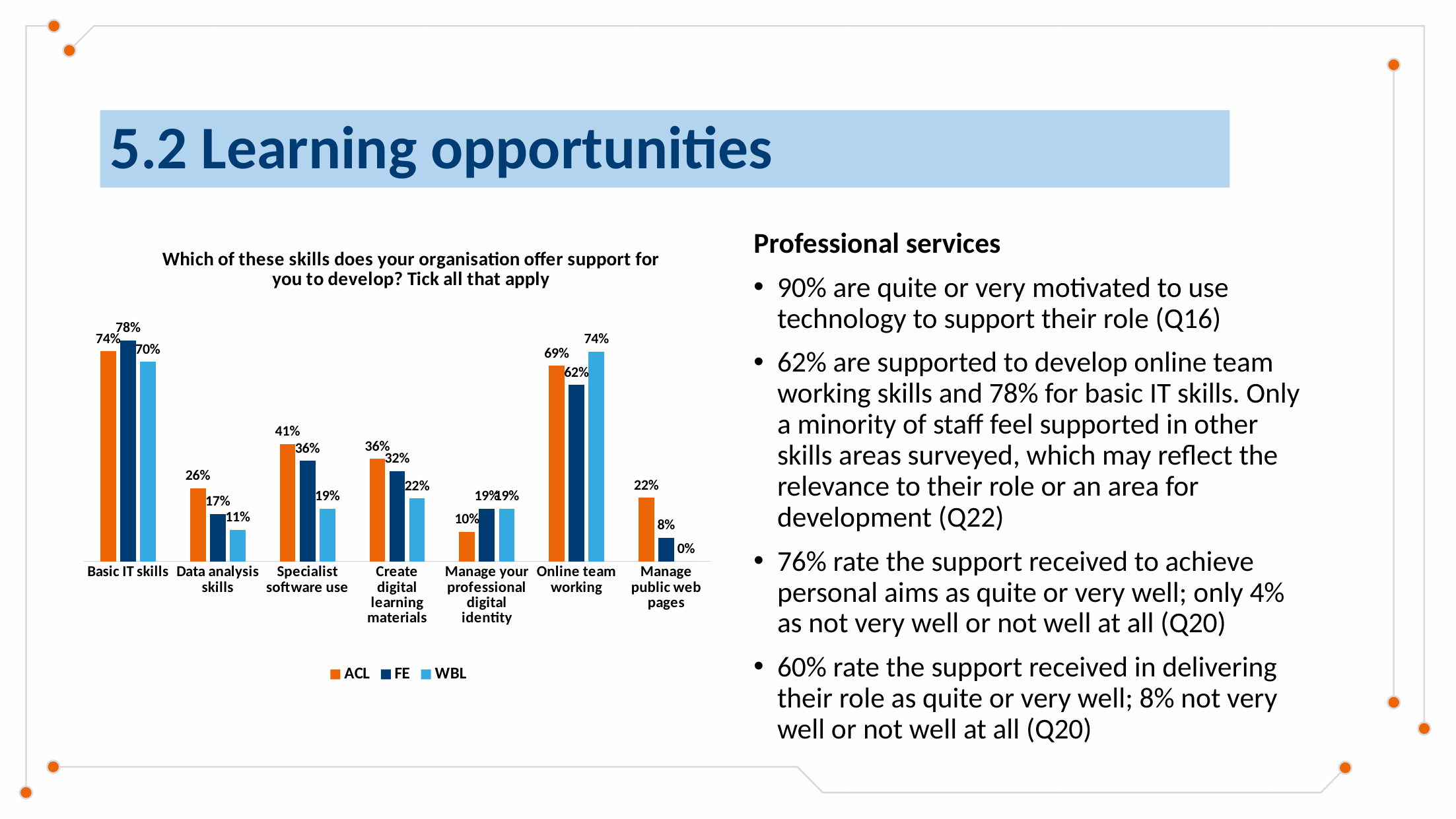
Which category has the highest FE value? Basic IT skills What is the difference between the ACL and FE values for Data analysis skills? 9% What is the WBL value for Online team working? 74% What is the WBL value for Manage public web pages? 0% What is the FE value for Manage public web pages? 8% Which category has the lowest ACL value? Manage your professional digital identity How many series does the legend list? 3 How many skill categories are shown on the x axis? 7 Which series is shown in orange in the legend? ACL What kind of chart is shown on the slide? Bar chart What is the ACL value for Basic IT skills? 74% Which is larger for Online team working, the ACL value or the FE value? ACL